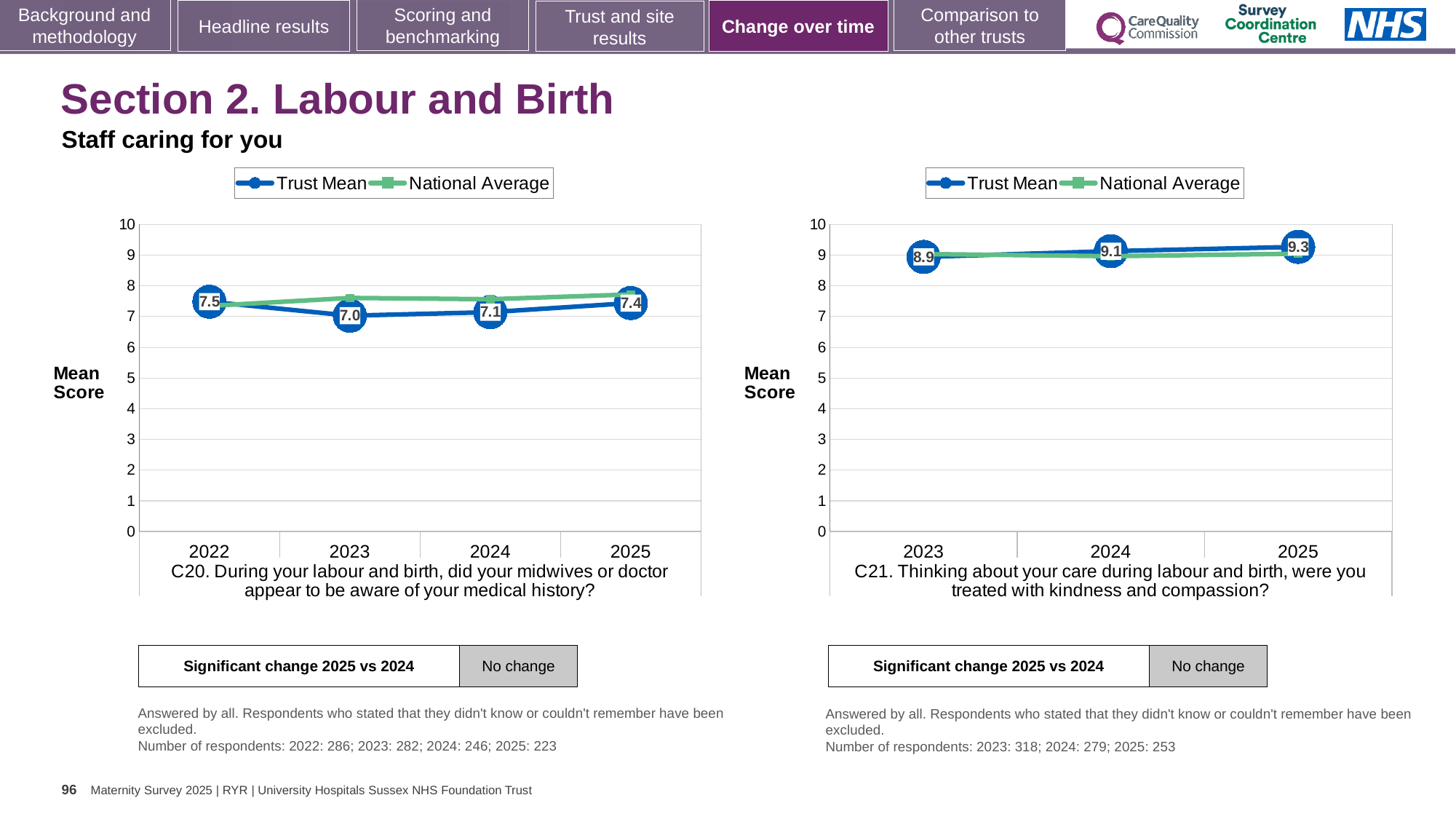
In the C21 chart (right), does the Trust Mean rise or fall from 2023 to 2025? rise In the C20 chart (left), which year has the lowest Trust Mean? 2023 In the C21 chart (right), is the Trust Mean for 2024 greater or less than the Trust Mean for 2023? greater In the C21 chart (right), what is the Trust Mean for 2023? 8.9 In the C21 chart (right), which year has the highest Trust Mean? 2025 In the C20 chart (left), which year has the highest Trust Mean? 2022 In the C20 chart (left), what is the difference between the Trust Mean for 2022 and 2023? 0.5 In the C20 chart (left), how many years are plotted on the x axis? 4 How many series does the legend of the C21 chart (right) list? 2 In the C21 chart (right), is the National Average for 2025 greater or less than 8? greater In the C20 chart (left), what is the Trust Mean for 2025? 7.4 In the C20 chart (left), what is the Trust Mean for 2023? 7.0